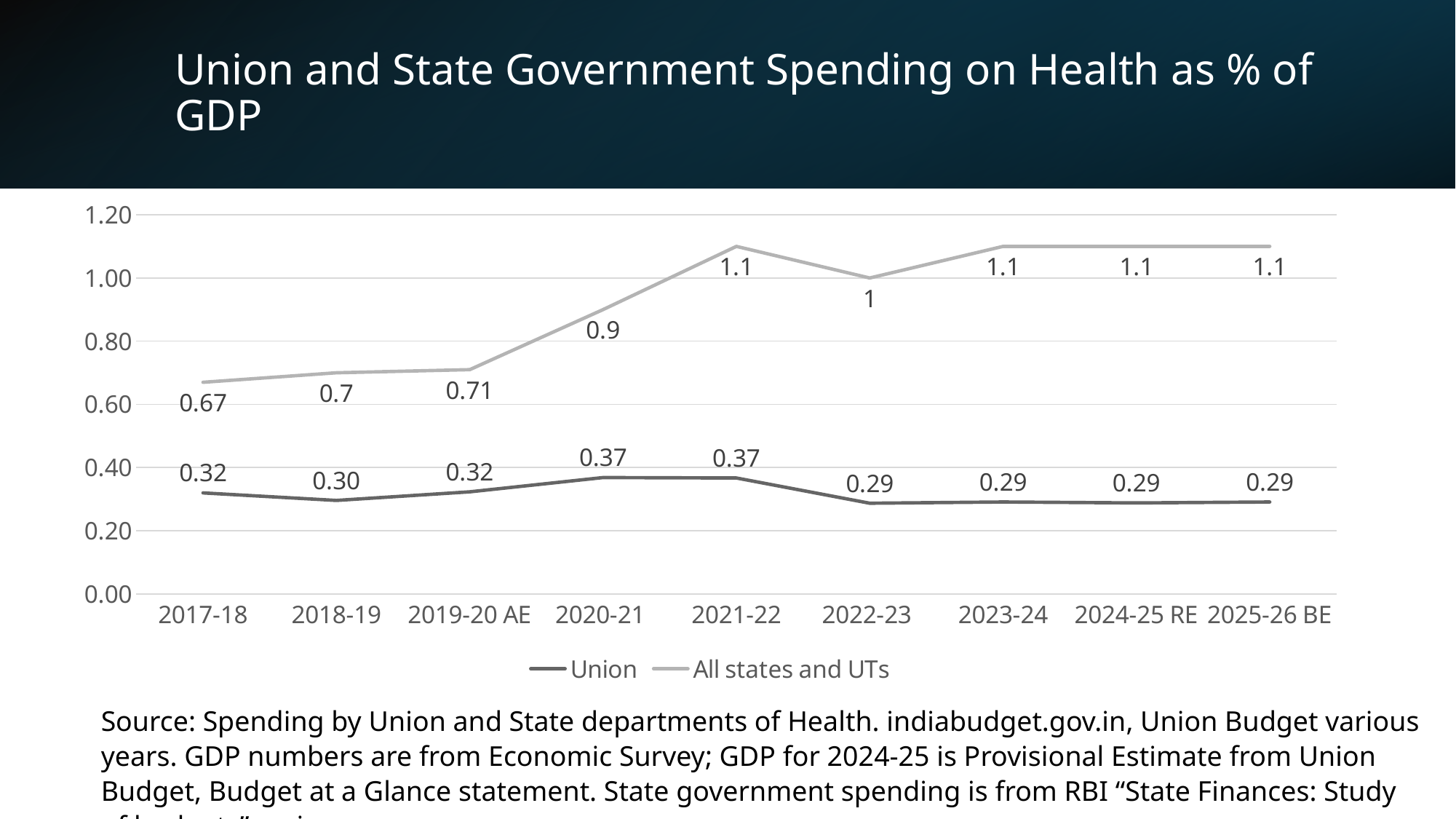
What is the Union value for 2025-26 BE? 0.29 In which year is the Union series at its lowest before 2022-23? 2018-19 How many series does the legend list? 2 What is the All states and UTs value for 2019-20 AE? 0.71 Which is larger in 2017-18: the Union value or the All states and UTs value? All states and UTs What is the All states and UTs value for 2022-23? 1 How many years are shown on the x axis? 9 What is the Union value for 2020-21? 0.37 Which year has the lowest All states and UTs value? 2017-18 Is the All states and UTs value for 2020-21 greater or less than 0.80? greater What is the difference between the All states and UTs value and the Union value in 2021-22? 0.73 What kind of chart is shown on the slide? Line chart